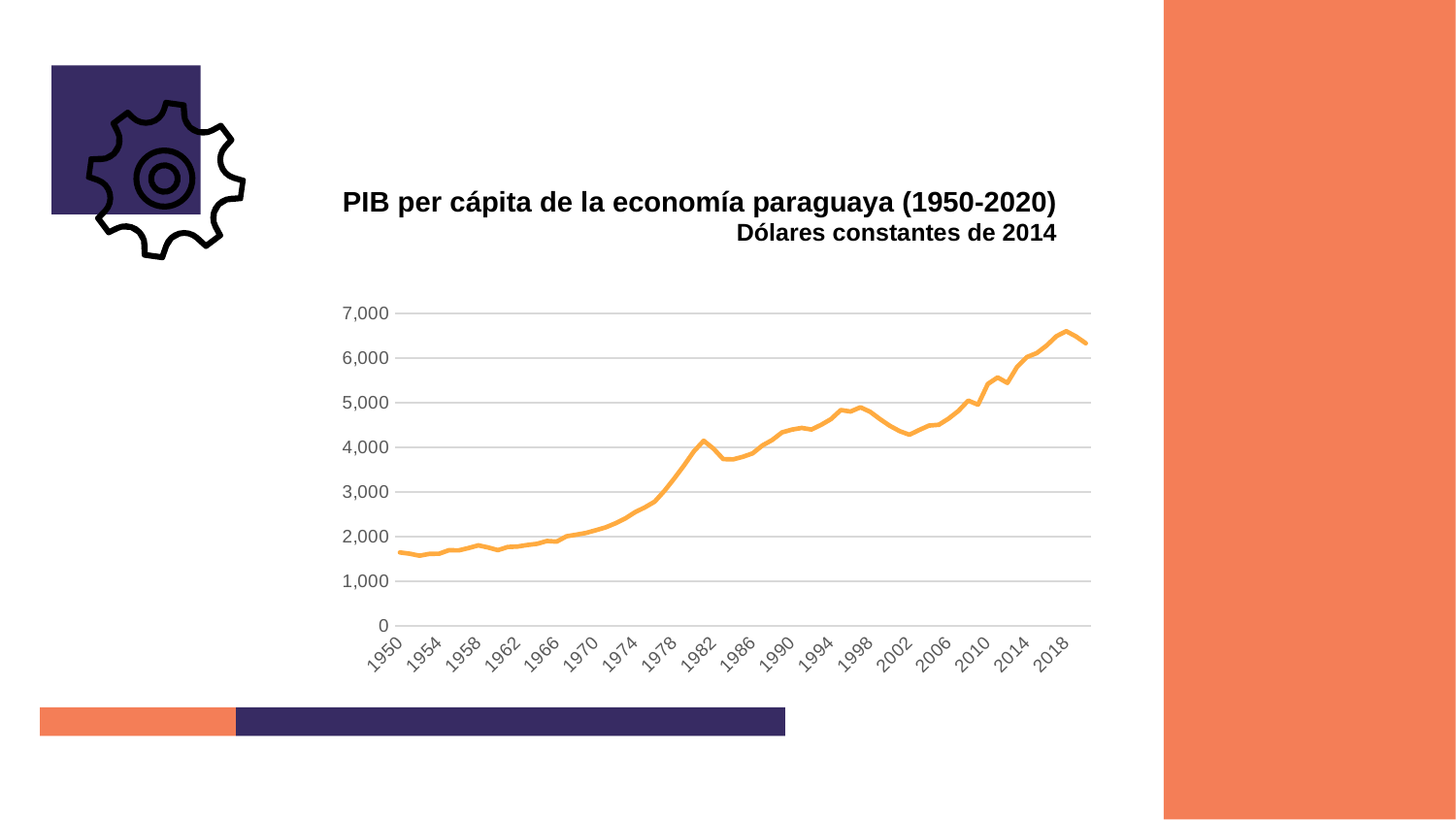
What is the title of the chart? PIB per cápita de la economía paraguaya (1950-2020) Which year has the larger value, 1950 or 2018? 2018 Overall, do the values rise or fall from 1950 to 2020? rise Is the value for 2018 greater or less than 6,000? greater What kind of chart is shown on the slide? line chart Is the value for 1970 greater or less than 3,000? less How many year labels are shown on the x axis? 18 Is the value for 1994 greater or less than 4,000? greater In what units are the values expressed, according to the chart subtitle? Dólares constantes de 2014 Which year has the larger value, 1982 or 1986? 1982